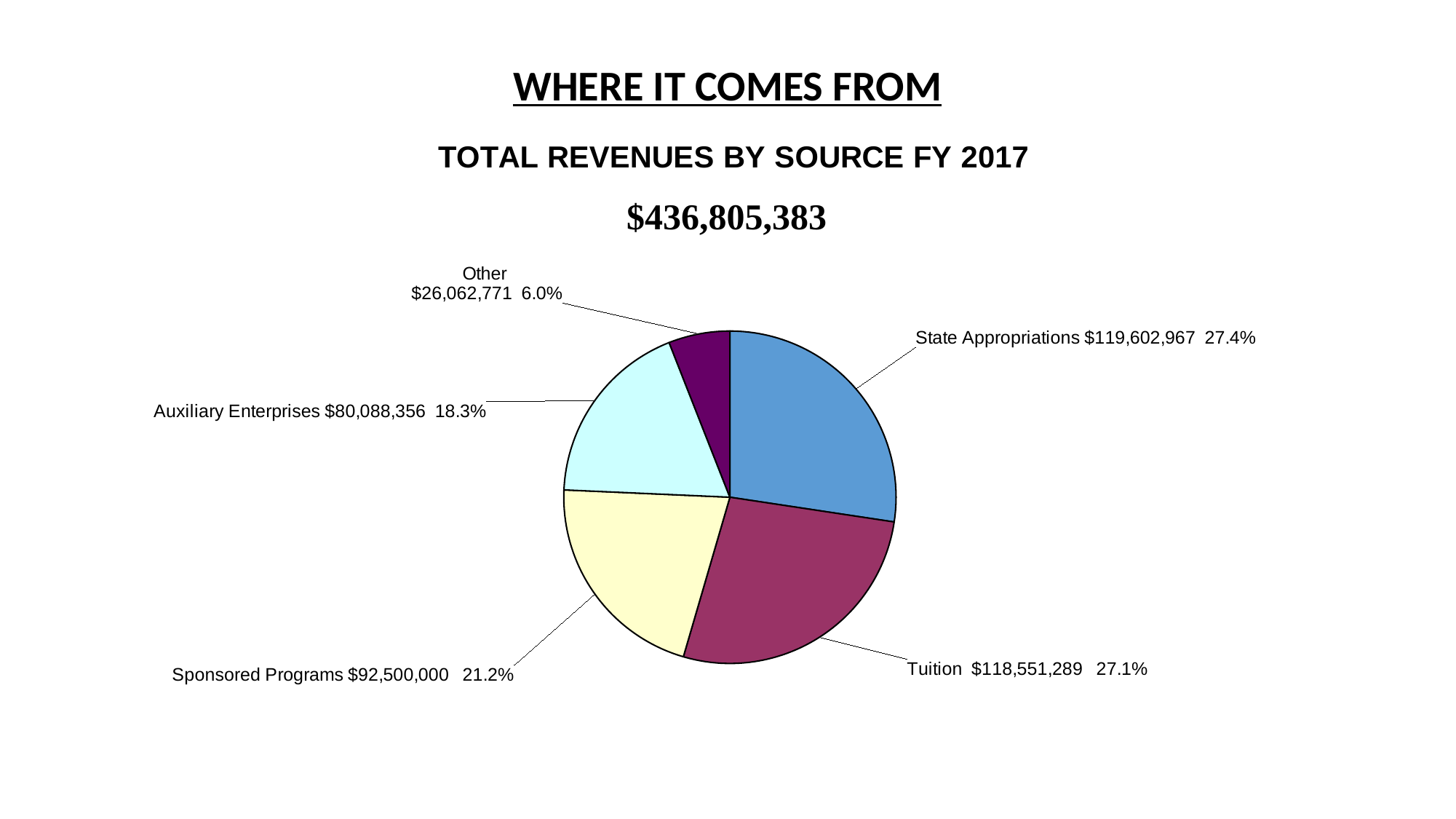
Which revenue source has the smallest share? Other How many slices does the pie chart have? 5 What is the revenue amount for Sponsored Programs? $92,500,000 What is the total revenue figure shown above the pie chart? $436,805,383 What is the revenue amount for State Appropriations? $119,602,967 What is the title of the chart? TOTAL REVENUES BY SOURCE FY 2017 What share of total revenues comes from Auxiliary Enterprises? 18.3% What type of chart is shown on the slide? Pie chart What is the difference in percentage share between Sponsored Programs and Auxiliary Enterprises? 2.9% Which revenue source has the largest share? State Appropriations Which is larger, the revenue from Sponsored Programs or from Auxiliary Enterprises? Sponsored Programs What percentage of total revenues comes from Tuition? 27.1%